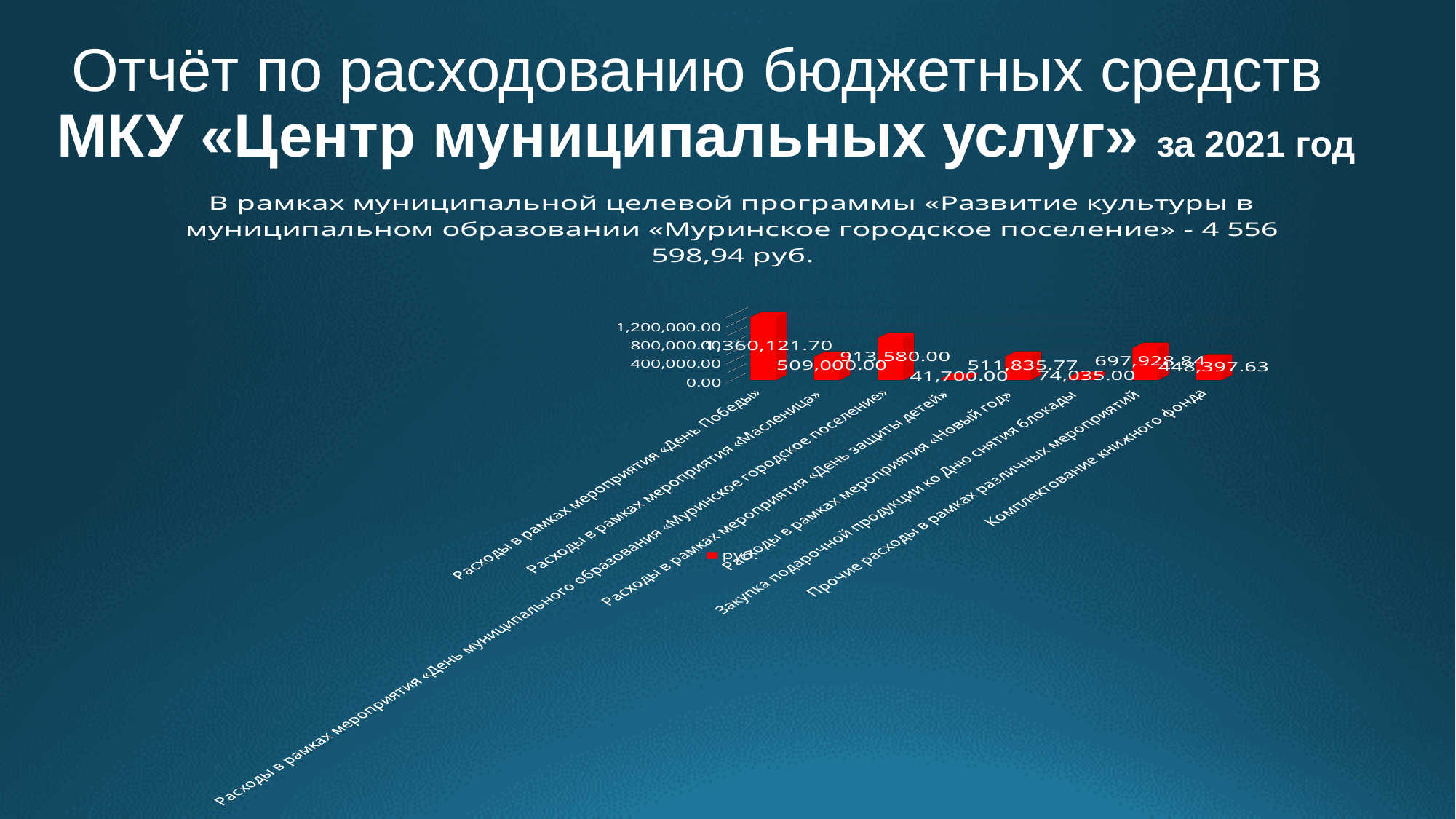
How many categories are shown in the chart? 8 Which category has the highest value? Расходы в рамках мероприятия «День Победы» What is the value for «Расходы в рамках мероприятия «День защиты детей»»? 41,700.00 What is the value for «Расходы в рамках мероприятия «День Победы»»? 1,360,121.70 Which is larger: the value for «Расходы в рамках мероприятия «День муниципального образования «Муринское городское поселение»» or for «Комплектование книжного фонда»? Расходы в рамках мероприятия «День муниципального образования «Муринское городское поселение» What type of chart is shown on the slide? bar chart What is the value for «Комплектование книжного фонда»? 448,397.63 What is the difference between the values for «День Победы» and «Масленица»? 851,121.70 Which category has the lowest value? Расходы в рамках мероприятия «День защиты детей» What is the value for «Закупка подарочной продукции ко Дню снятия блокады»? 74,035.00 What is the single legend entry of the chart? руб. What is the value for «Расходы в рамках мероприятия «Масленица»»? 509,000.00